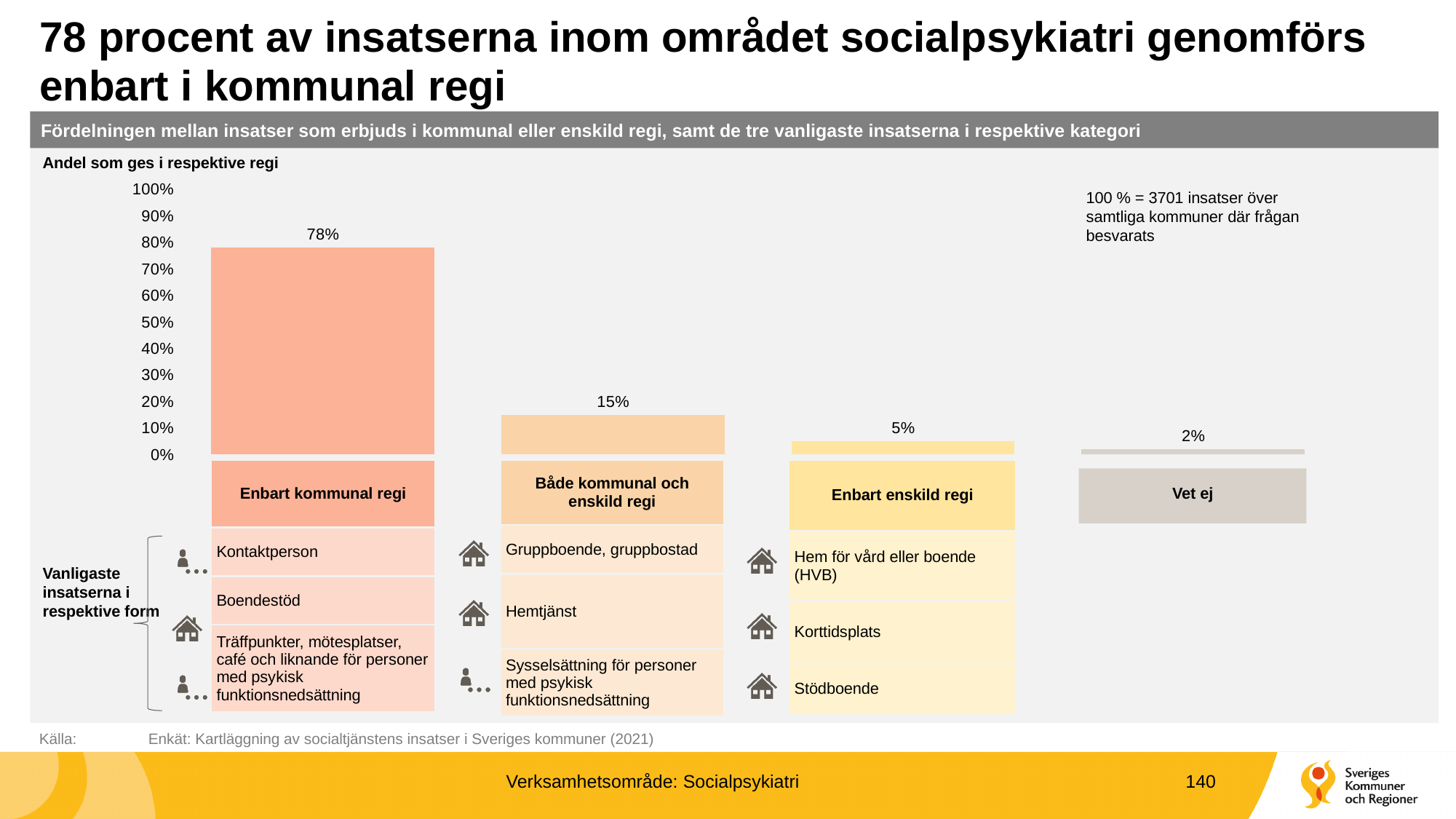
What is the value for Enbart kommunal regi? 78% Which is larger, the value for Enbart enskild regi or the value for Vet ej? Enbart enskild regi Is the value for Både kommunal och enskild regi greater or less than 20%? less What is the value for Vet ej? 2% According to the note on the chart, how many insatser does 100% correspond to? 3701 What is the difference between the values for Enbart kommunal regi and Både kommunal och enskild regi? 63 percentage points What is the value for Enbart enskild regi? 5% What kind of chart is shown on the slide? bar chart Which category has the highest value? Enbart kommunal regi What is the value for Både kommunal och enskild regi? 15% How many categories are shown in the chart? 4 Which category has the lowest value? Vet ej